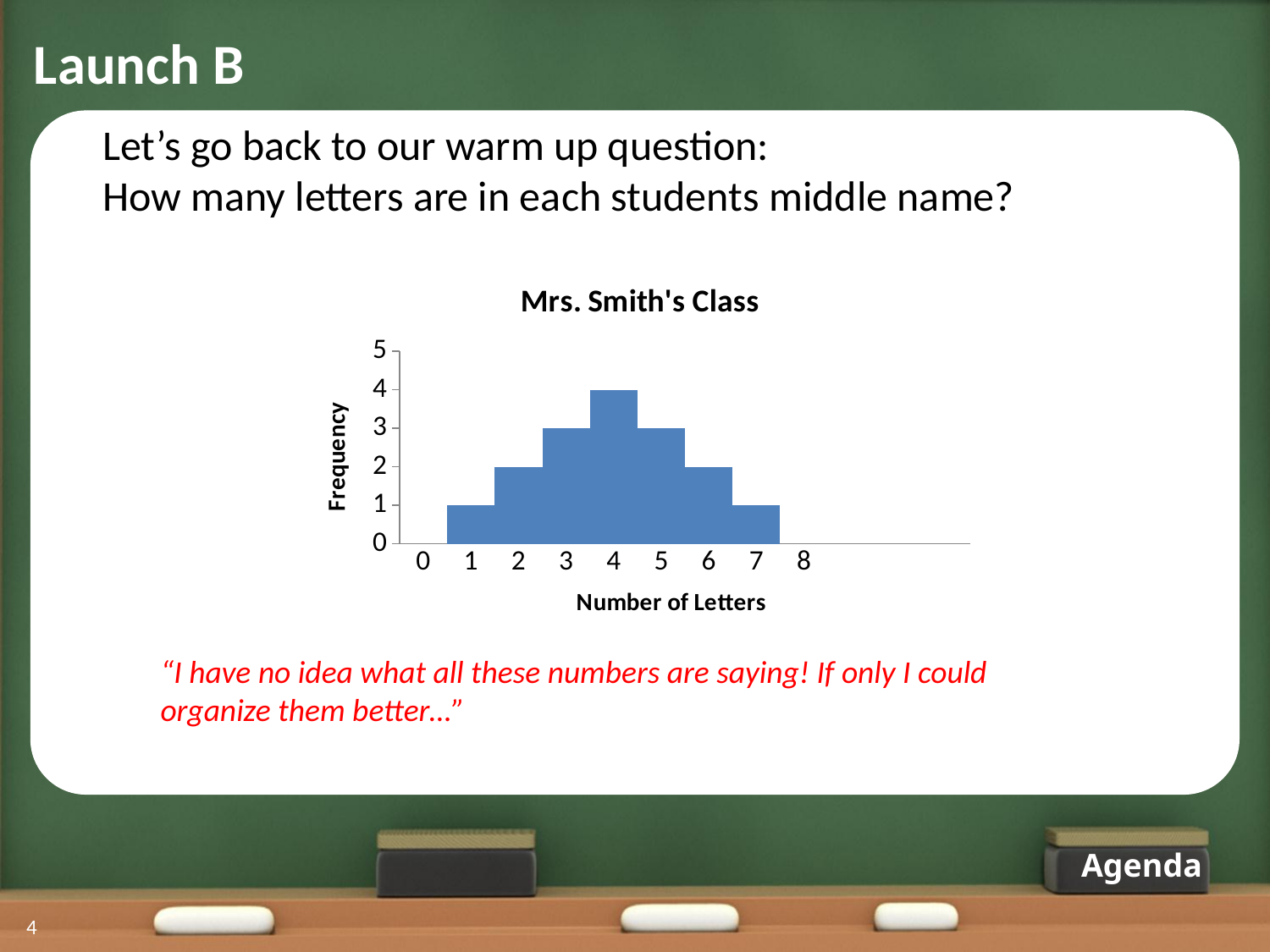
Do the frequencies rise or fall from 4 letters to 7 letters? fall What is the label of the x axis? Number of Letters What kind of chart is shown on the slide? bar chart Is the frequency for 5 letters greater or less than 2? greater What is the difference between the frequency for 4 letters and the frequency for 1 letter? 3 What is the frequency for 2 letters? 2 Which has a higher frequency, 3 letters or 6 letters? 3 letters Which number of letters has the highest frequency? 4 What is the frequency for 4 letters? 4 How many bars are plotted in the chart? 7 What is the frequency for 7 letters? 1 What is the title of the chart? Mrs. Smith's Class